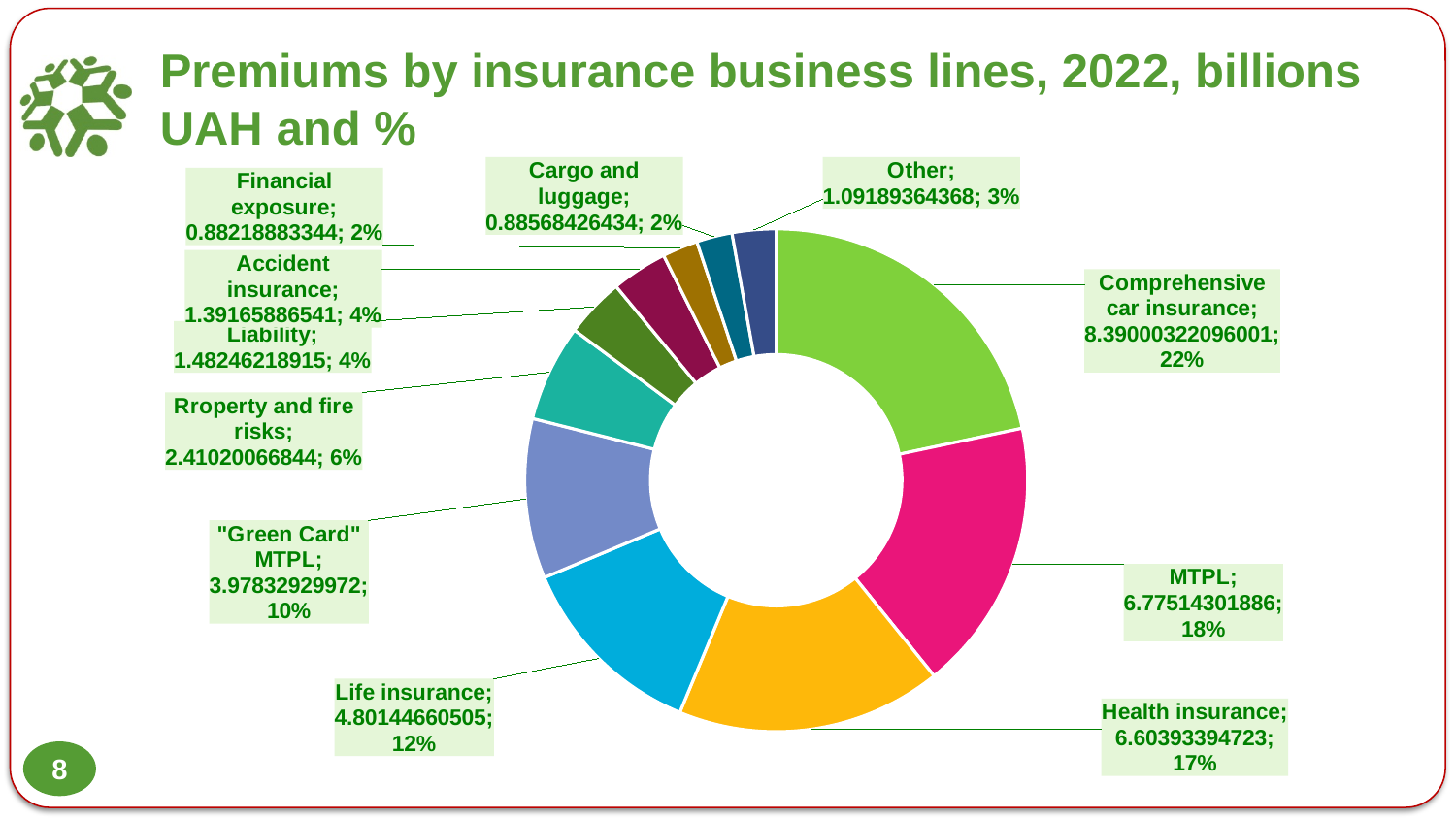
What share of premiums does Life insurance account for? 12% What is the title of the chart? Premiums by insurance business lines, 2022, billions UAH and % What is the premium value for Health insurance? 6.60393394723 How many insurance business lines (slices) are shown in the chart? 11 What is the difference in percentage share between Comprehensive car insurance and MTPL? 4% What share of premiums does the Other category account for? 3% What share of premiums does MTPL account for? 18% Which has a larger share of premiums, "Green Card" MTPL or Rroperty and fire risks? "Green Card" MTPL What kind of chart is shown on the slide? Pie chart (doughnut) Which insurance business line has the largest share of premiums? Comprehensive car insurance What is the premium value for Comprehensive car insurance? 8.39000322096001 Which insurance business line has the smallest premium value? Financial exposure